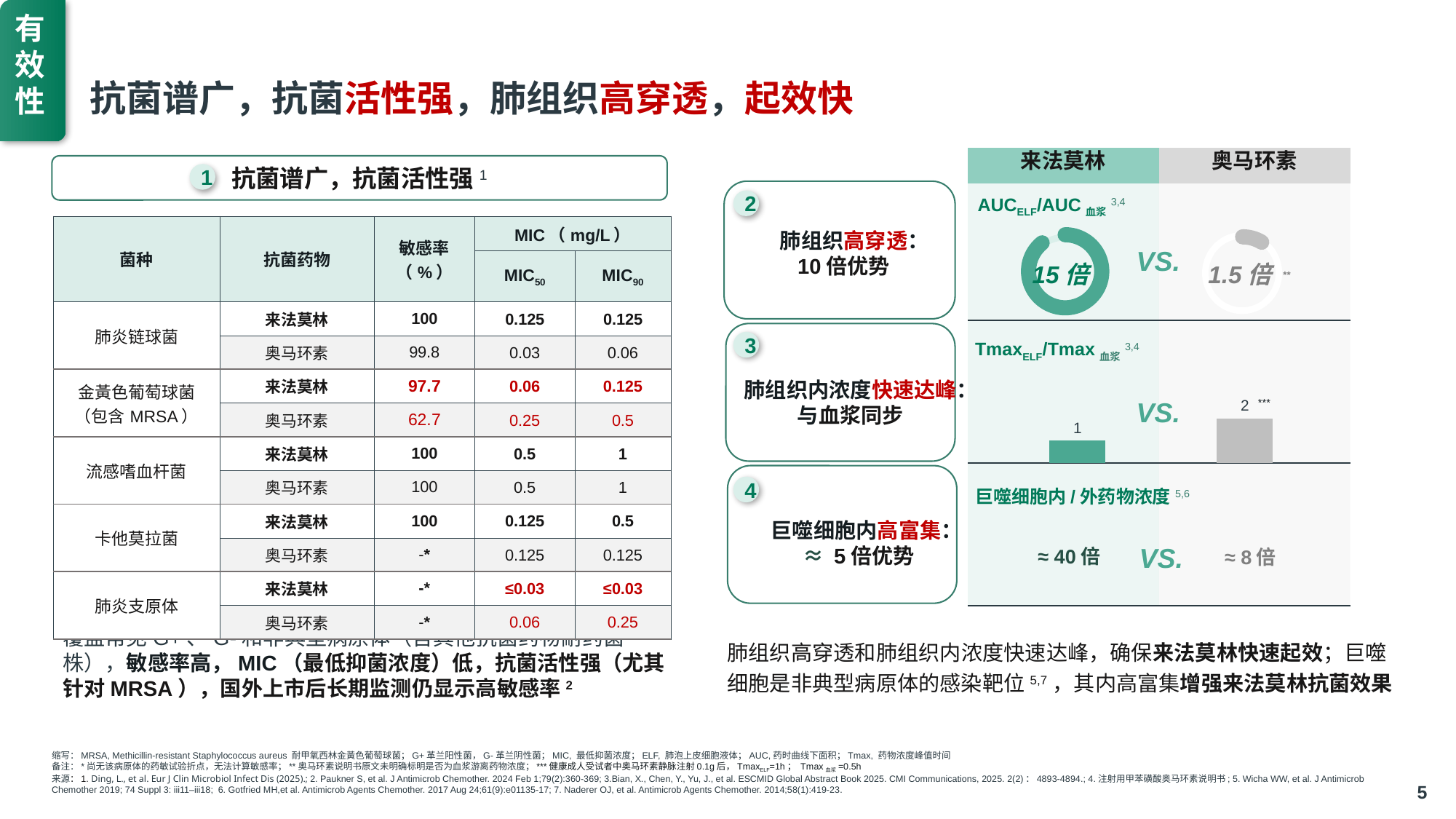
What kind of chart is used to show the AUC_ELF/AUC血浆 comparison? Ring (donut) chart How many bars are in the Tmax_ELF/Tmax血浆 bar chart? 2 In the Tmax_ELF/Tmax血浆 bar chart, which drug has the higher bar? 奥马环素 In the Tmax_ELF/Tmax血浆 bar chart, what is the difference between the 奥马环素 value and the 来法莫林 value? 1 In the Tmax_ELF/Tmax血浆 bar chart, what colour is the bar for 奥马环素? Grey In the Tmax_ELF/Tmax血浆 bar chart, what value is shown for 来法莫林? 1 In the AUC_ELF/AUC血浆 ring chart, what value is shown for 来法莫林? 15 倍 What kind of chart is used to show the Tmax_ELF/Tmax血浆 comparison? Bar chart In the Tmax_ELF/Tmax血浆 bar chart, what colour is the bar for 来法莫林? Green In the AUC_ELF/AUC血浆 ring chart, what value is shown for 奥马环素? 1.5 倍 In the AUC_ELF/AUC血浆 ring chart, which drug has the larger value, 来法莫林 or 奥马环素? 来法莫林 In the Tmax_ELF/Tmax血浆 bar chart, what value is shown for 奥马环素? 2